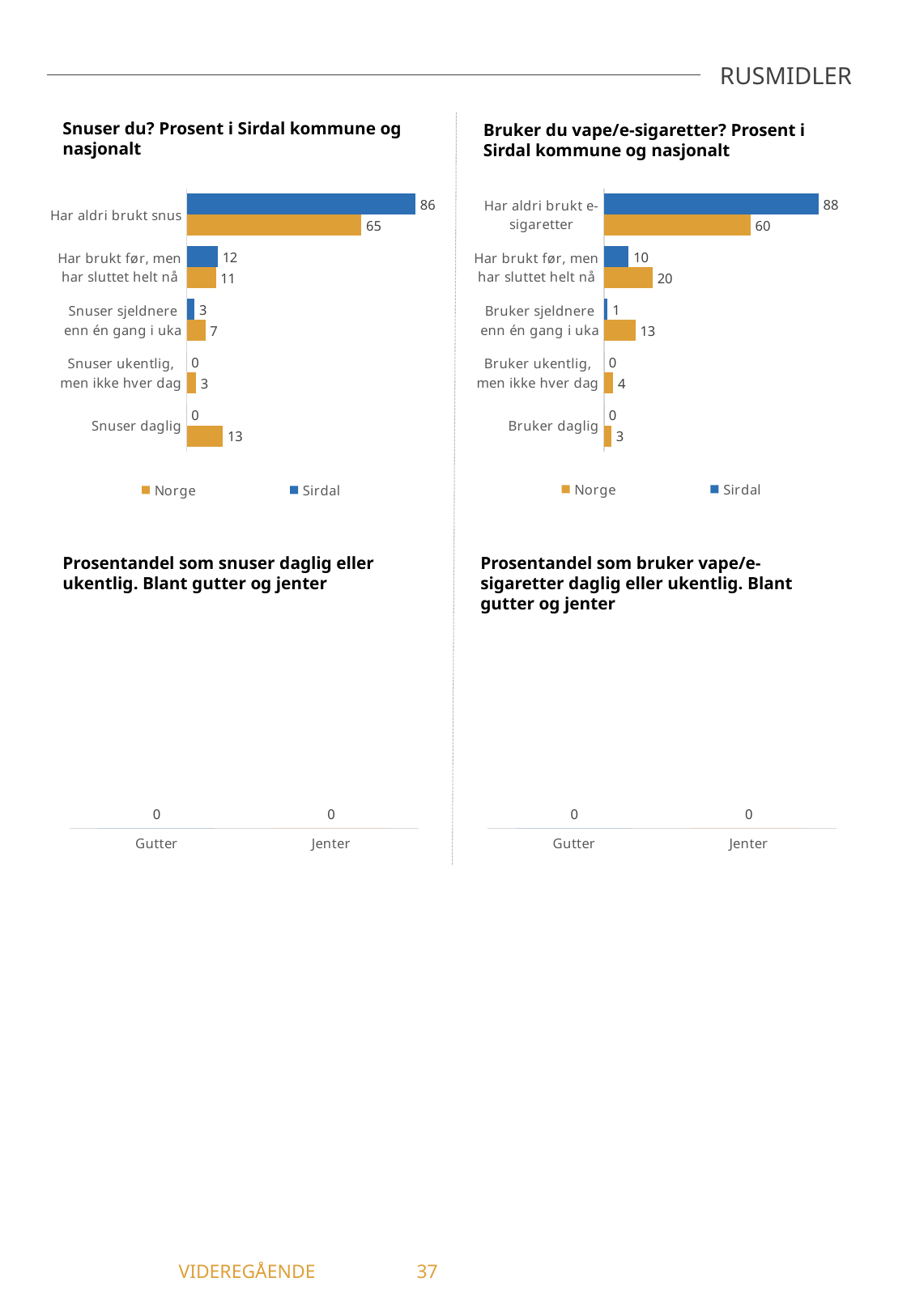
In the chart 'Snuser du? Prosent i Sirdal kommune og nasjonalt', which category has the highest Norge value? Har aldri brukt snus In the chart 'Bruker du vape/e-sigaretter? Prosent i Sirdal kommune og nasjonalt', what is the value for Sirdal for 'Bruker sjeldnere enn én gang i uka'? 1 In the chart 'Bruker du vape/e-sigaretter? Prosent i Sirdal kommune og nasjonalt', which is larger for 'Har brukt før, men har sluttet helt nå': Norge or Sirdal? Norge In the chart 'Snuser du? Prosent i Sirdal kommune og nasjonalt', how many categories are shown? 5 In the chart 'Bruker du vape/e-sigaretter? Prosent i Sirdal kommune og nasjonalt', what is the value for Norge for 'Har brukt før, men har sluttet helt nå'? 20 How many series does the legend list in the chart 'Bruker du vape/e-sigaretter? Prosent i Sirdal kommune og nasjonalt'? 2 In the chart 'Prosentandel som snuser daglig eller ukentlig. Blant gutter og jenter', what is the value for Jenter? 0 What kind of chart is 'Snuser du? Prosent i Sirdal kommune og nasjonalt'? Bar chart In the chart 'Snuser du? Prosent i Sirdal kommune og nasjonalt', what is the value for Sirdal for 'Har aldri brukt snus'? 86 In the chart 'Snuser du? Prosent i Sirdal kommune og nasjonalt', what is the value for Norge for 'Snuser daglig'? 13 In the chart 'Snuser du? Prosent i Sirdal kommune og nasjonalt', what is the difference between the Sirdal and Norge values for 'Har aldri brukt snus'? 21 In the chart 'Bruker du vape/e-sigaretter? Prosent i Sirdal kommune og nasjonalt', what is the difference between the Sirdal and Norge values for 'Har aldri brukt e-sigaretter'? 28